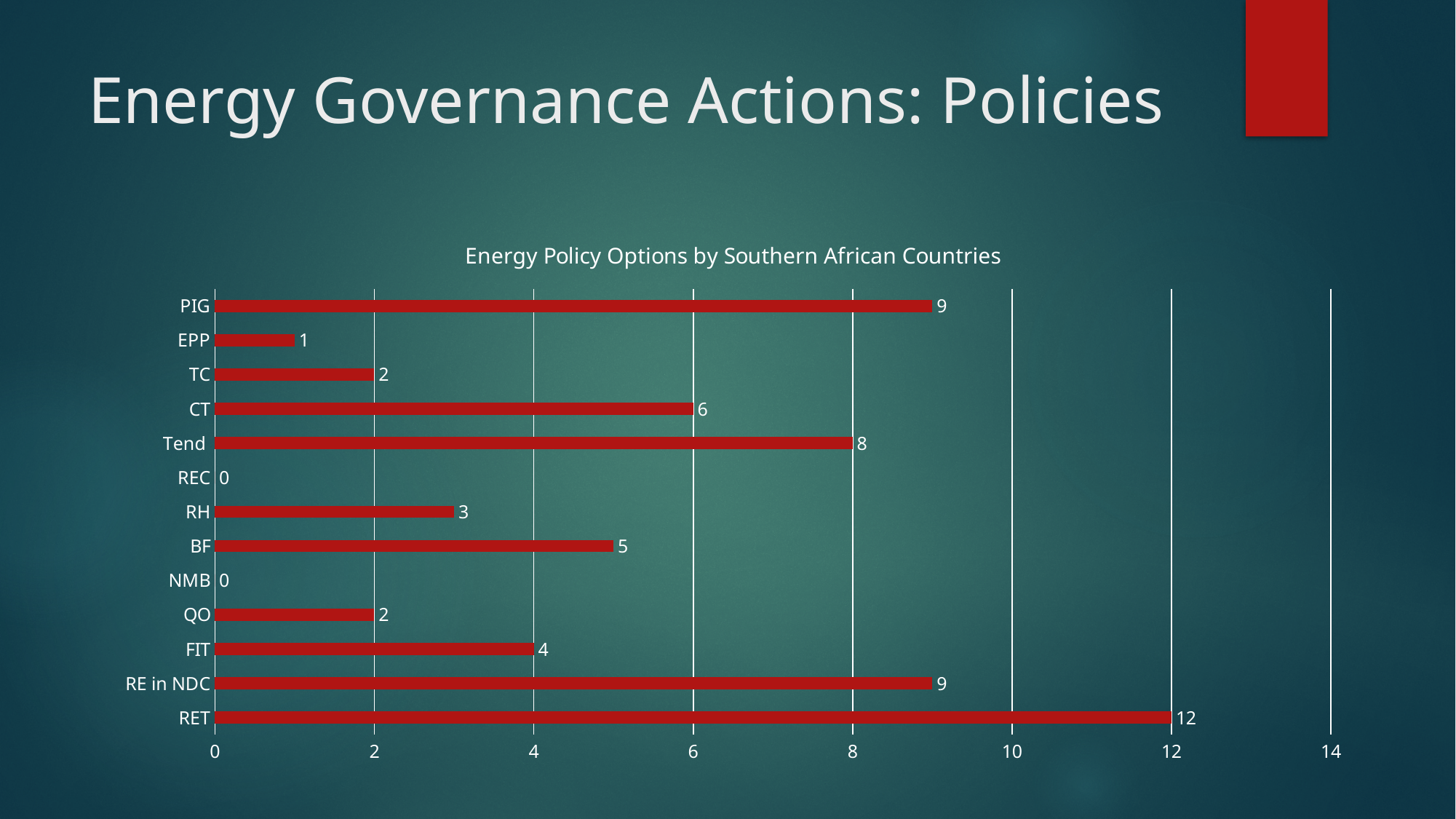
What is the difference between the values for CT and RH? 3 What is the value for BF? 5 How many categories are shown on the chart? 13 What is the title of the chart? Energy Policy Options by Southern African Countries What is the value for RET? 12 Which categories have a value of 0? REC and NMB What kind of chart is shown on the slide? Bar chart Is the value for Tend greater or less than 6? greater What is the value for Tend? 8 What is the difference between the values for RET and PIG? 3 Which is larger, the value for FIT or the value for BF? BF Which category has the highest value? RET